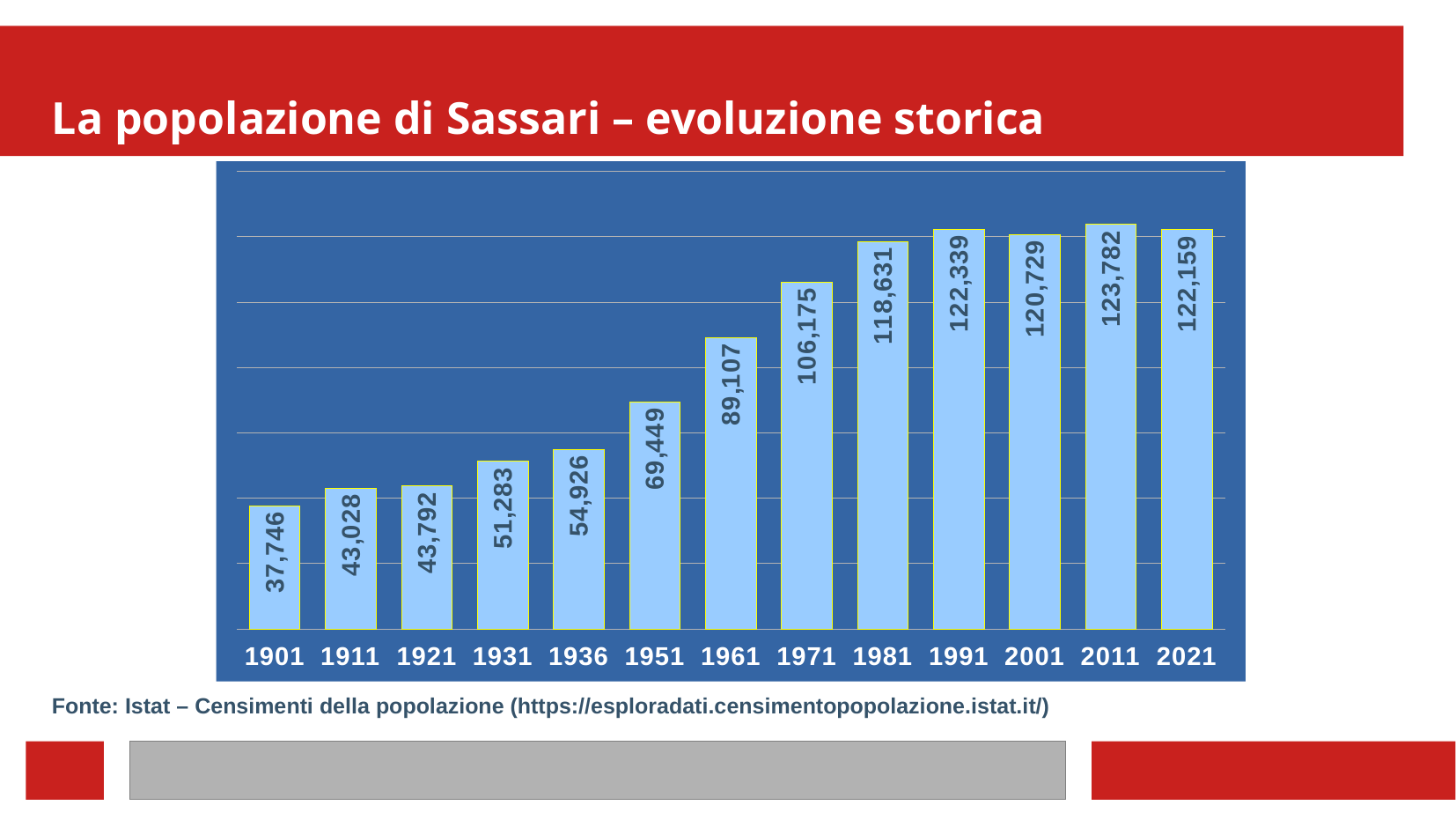
Which year has the highest population value? 2011 Do the population values generally rise or fall from 1901 to 1991? Rise What is the population value shown for 2021? 122,159 How many census years are shown on the x axis? 13 Which year has the lowest population value? 1901 What kind of chart is shown on the slide? Bar chart What is the difference between the population values for 2021 and 1901? 84,413 What is the title of the slide containing the chart? La popolazione di Sassari – evoluzione storica Which is larger, the population value for 1991 or for 2001? 1991 What is the difference between the population values for 2011 and 2001? 3,053 What is the population value shown for 1971? 106,175 What is the population value shown for 1901? 37,746